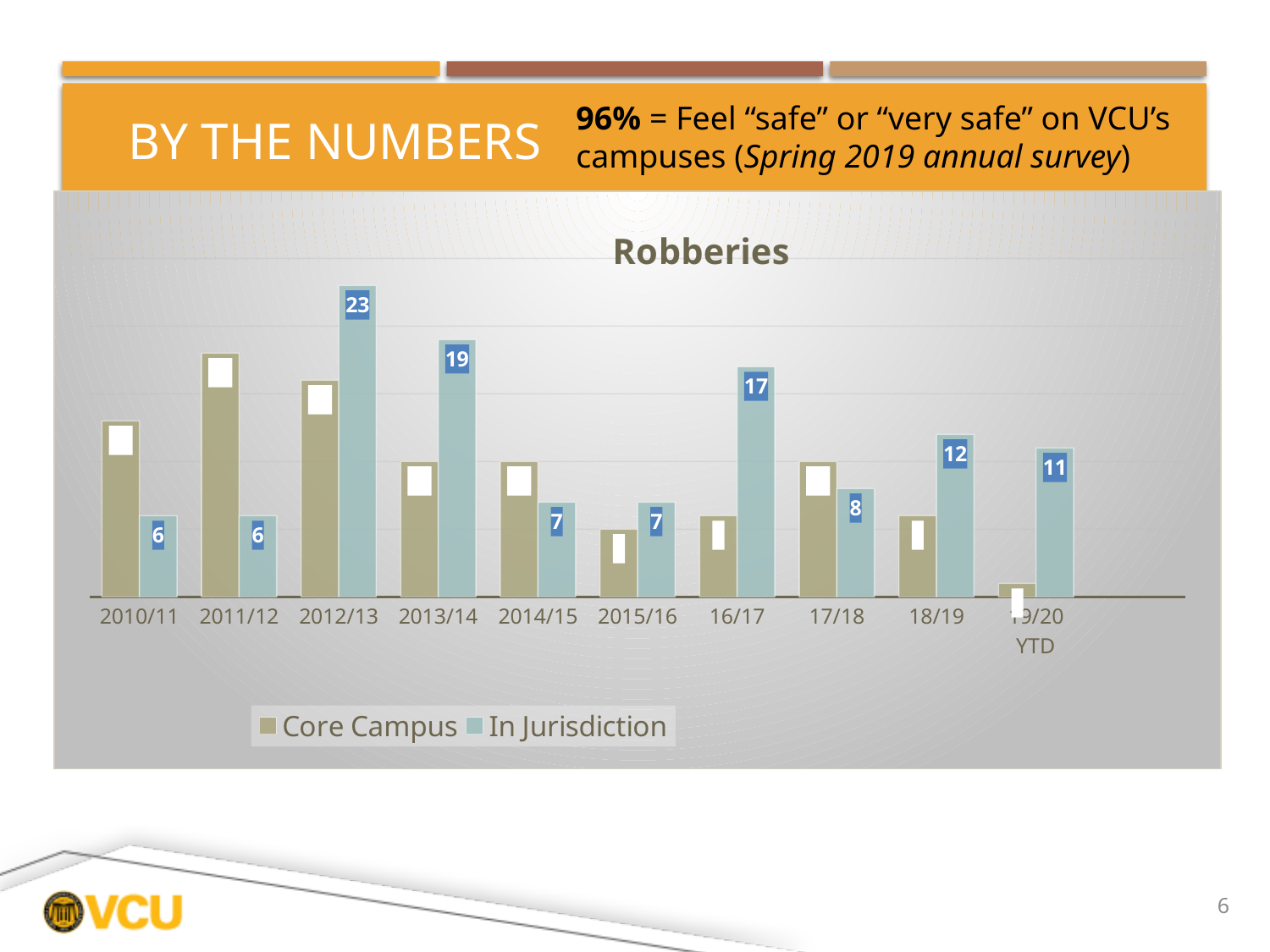
What is the lowest In Jurisdiction value shown in the Robberies chart? 6 What is the In Jurisdiction value for 2013/14 in the Robberies chart? 19 In 2011/12, which series has the larger value: Core Campus or In Jurisdiction? Core Campus What is the In Jurisdiction value for 2012/13 in the Robberies chart? 23 What is the difference between the In Jurisdiction values for 16/17 and 18/19? 5 What is the difference between the In Jurisdiction values for 2012/13 and 2013/14? 4 What is the In Jurisdiction value for 17/18 in the Robberies chart? 8 What is the In Jurisdiction value for 19/20 YTD in the Robberies chart? 11 Which is larger: the In Jurisdiction value for 16/17 or for 17/18? 16/17 How many series does the legend of the Robberies chart list? 2 Which year has the highest In Jurisdiction value in the Robberies chart? 2012/13 How many year categories are shown on the x axis of the Robberies chart? 10